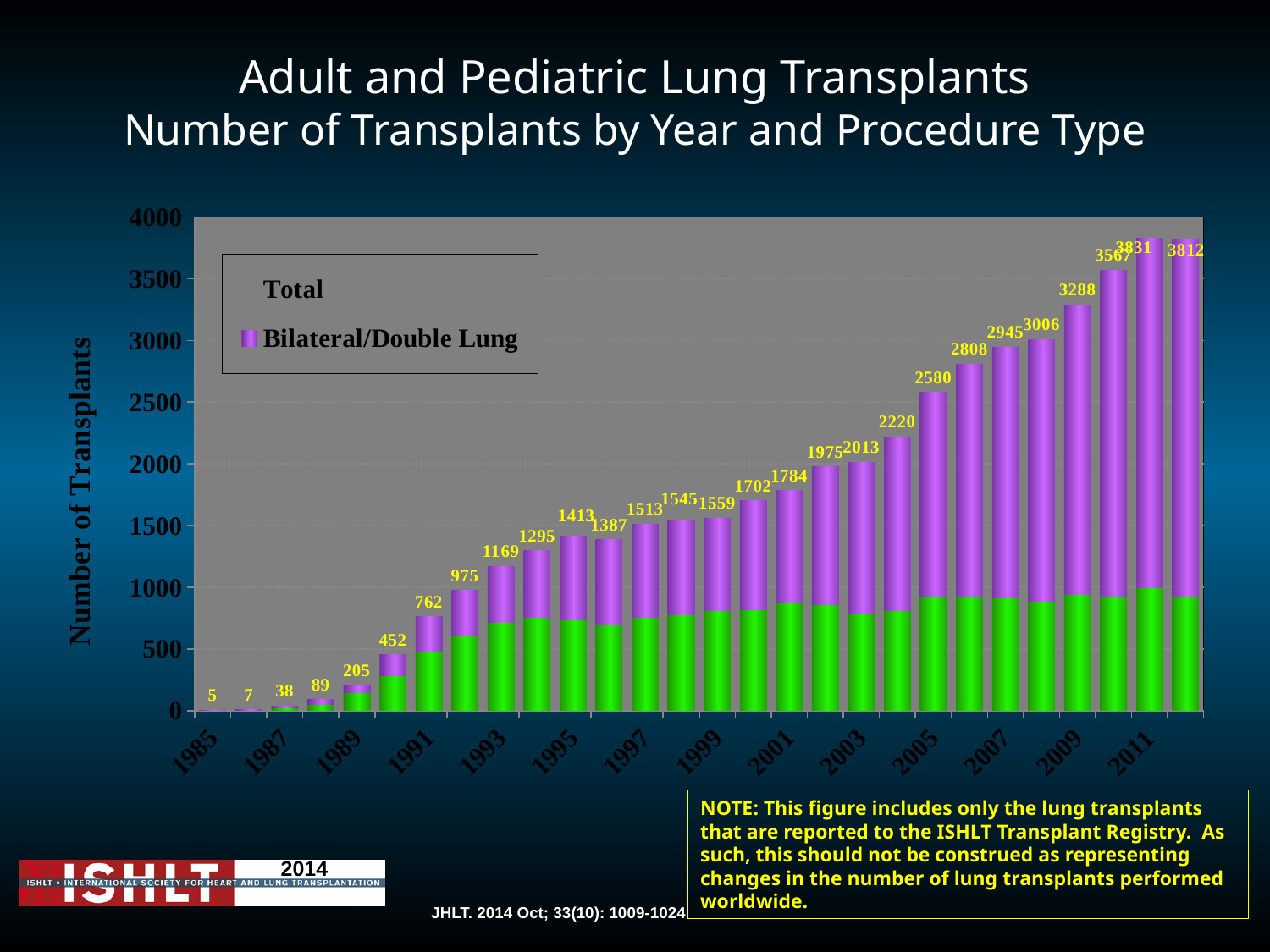
What is the total number of lung transplants shown for 1991? 762 Which year has the highest total number of transplants? 2011 What is the difference between the total transplants in 2009 and 2007? 343 Is the Bilateral/Double Lung value for 2011 greater or less than 2500? greater Do the total transplant numbers generally rise or fall from 1985 to 2011? Rise What is the total number of lung transplants shown for 2005? 2580 Is the green (bottom) segment for 2003 greater or less than 1000? less Which year has a larger total, 1995 or 1997? 1997 Which year has the lowest total number of transplants? 1985 What kind of chart is shown on the slide? Stacked bar chart What is the total number of lung transplants shown for 1985? 5 What is the label of the y axis? Number of Transplants